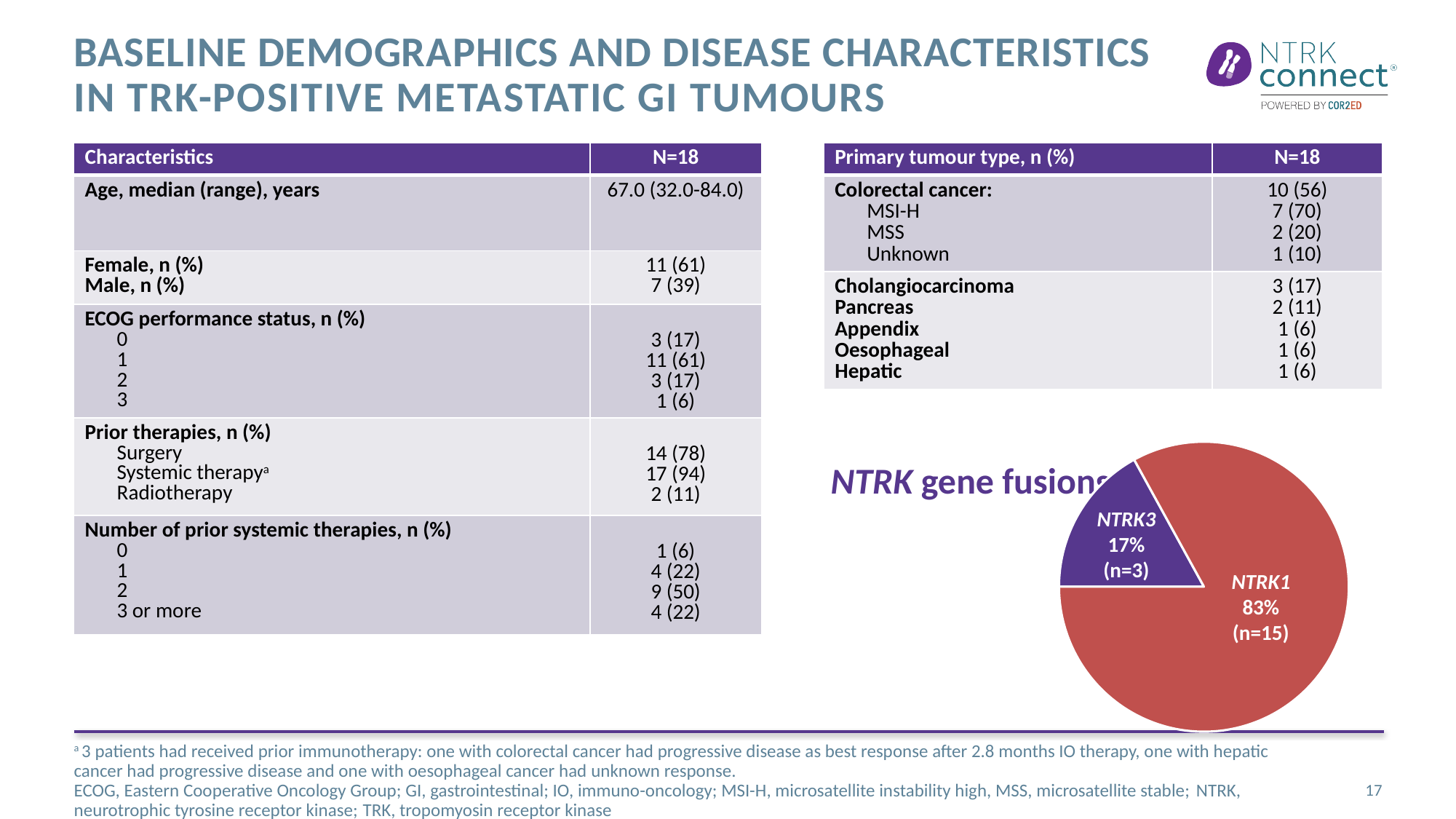
How many patients (n) are in the NTRK3 slice of the pie chart? 3 How many patients (n) are in the NTRK1 slice of the pie chart? 15 What is the title of the pie chart? NTRK gene fusions What is the total number of patients represented in the pie chart (sum of the n values)? 18 What share of the pie chart does NTRK1 represent? 83% By how many percentage points does the NTRK1 share exceed the NTRK3 share in the pie chart? 66 Which gene fusion has the smallest slice in the pie chart? NTRK3 How many slices does the pie chart have? 2 What share of the pie chart does NTRK3 represent? 17% Which slice is larger in the pie chart, NTRK1 or NTRK3? NTRK1 What kind of chart is shown on the slide? pie chart Which gene fusion has the largest slice in the pie chart? NTRK1